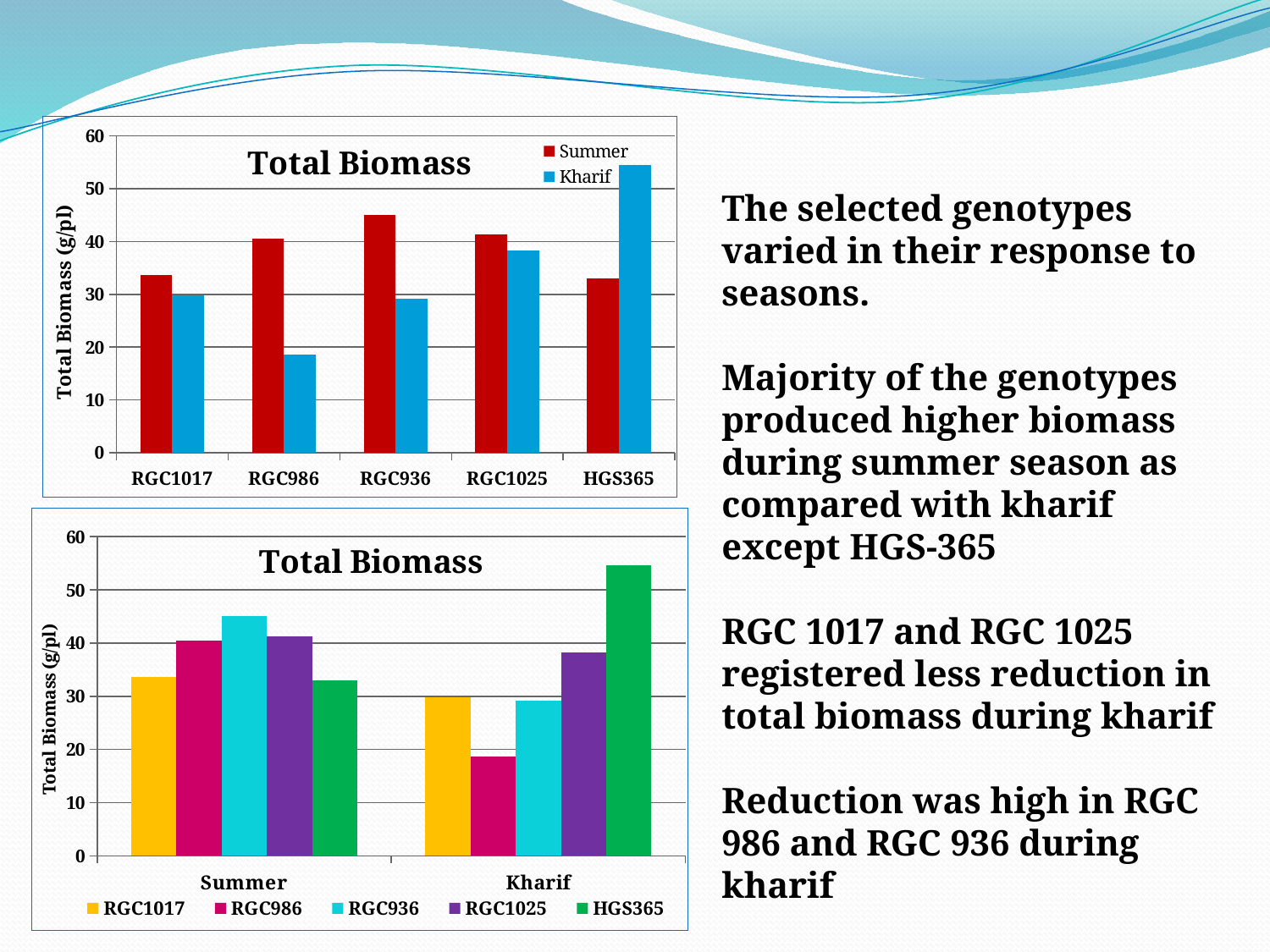
In the top chart, how many genotype categories are shown on the x axis? 5 In the top chart, how many series does the legend list? 2 In the top chart, which genotype has the highest Summer value? RGC936 In the bottom chart, is the Summer value for RGC936 greater or less than 40? greater What is the y-axis label of the bottom chart? Total Biomass (g/pl) In the top chart, is the Kharif value for HGS365 greater or less than 50? greater In the top chart, which genotype has the lowest Kharif value? RGC986 In the top chart, which genotype has the highest Kharif value? HGS365 In the top chart, is the Kharif value for RGC986 greater or less than 20? less In the bottom chart, which is larger for HGS365: the Summer value or the Kharif value? Kharif What kind of chart is the top chart? Bar chart In the bottom chart, how many series does the legend list? 5